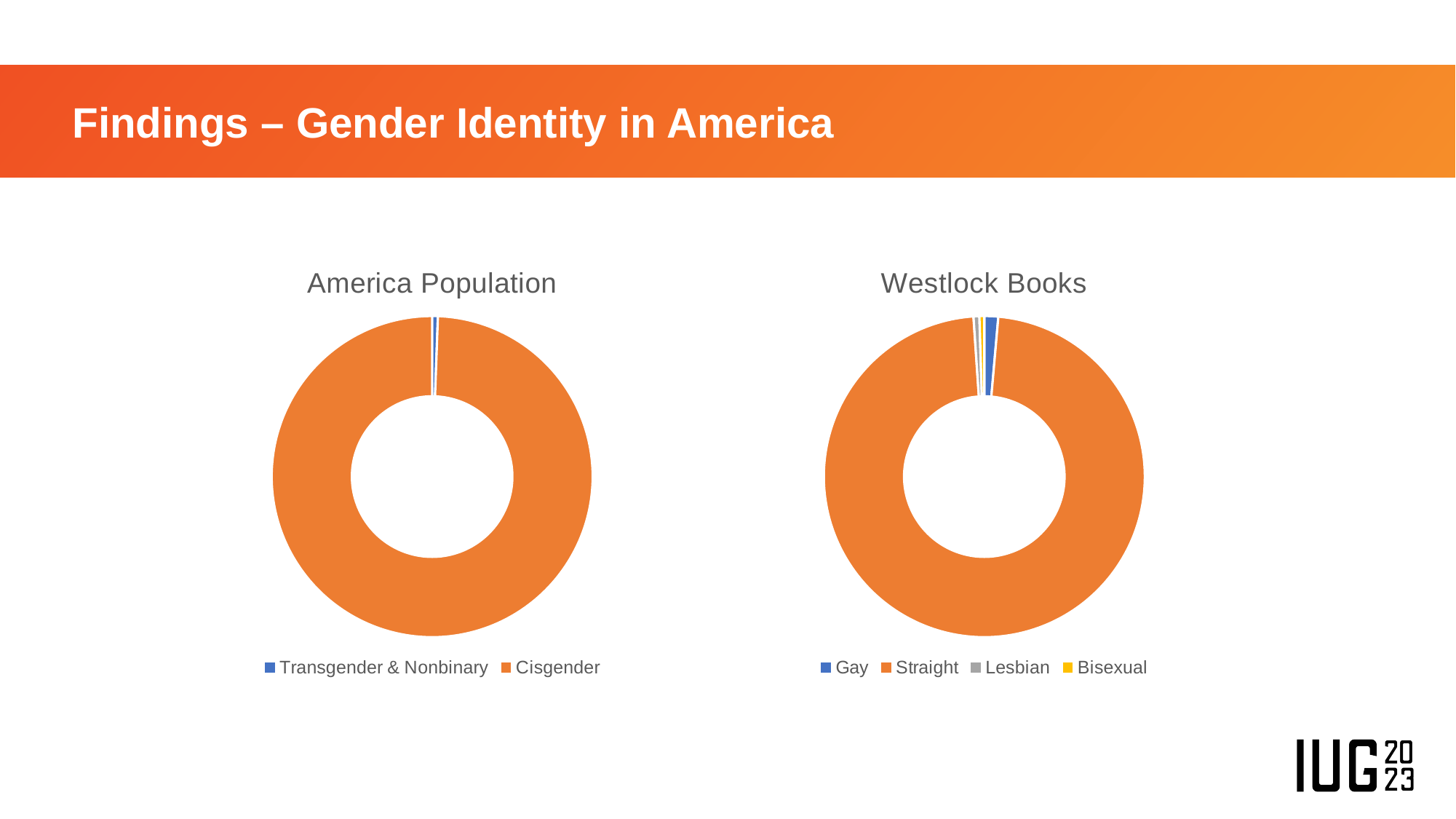
In the Westlock Books chart, how many categories does the legend list? 4 What is the title of the chart on the left? America Population What kind of chart is the Westlock Books chart? Doughnut (pie) chart In the America Population chart, how many categories does the legend list? 2 In the Westlock Books chart, which is larger, the Straight slice or the Gay slice? Straight In the Westlock Books chart, what colour represents the Bisexual category? Yellow In the Westlock Books chart, which category has the largest share? Straight In the America Population chart, which category has the smallest share? Transgender & Nonbinary In the America Population chart, which category has the largest share? Cisgender What kind of chart is the America Population chart? Doughnut (pie) chart In the America Population chart, which is larger, Cisgender or Transgender & Nonbinary? Cisgender